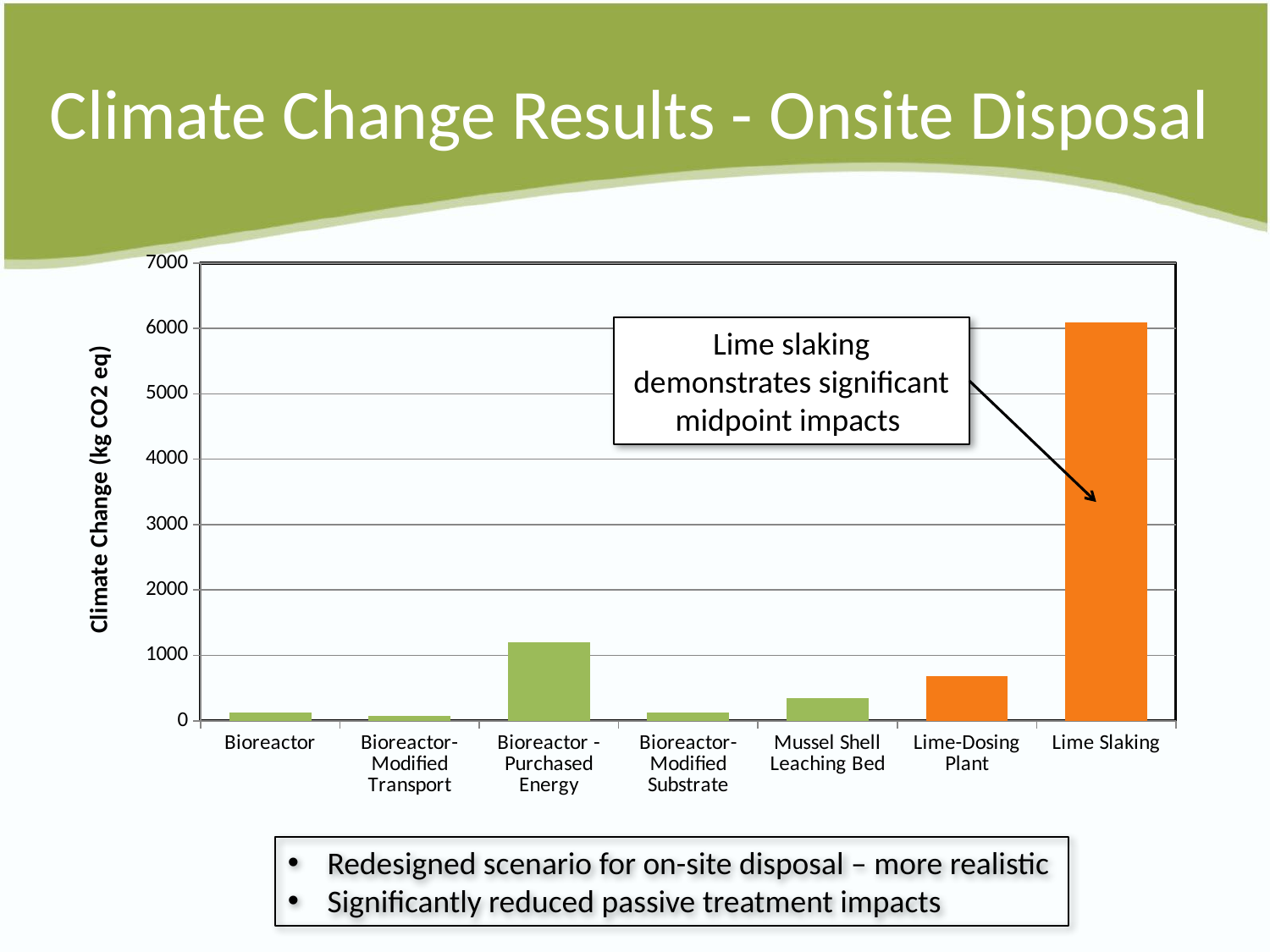
Which is larger, the value for Bioreactor - Purchased Energy or the value for Lime-Dosing Plant? Bioreactor - Purchased Energy What kind of chart is shown on the slide? bar chart Which category has the lowest climate change value? Bioreactor-Modified Transport Is the value for Mussel Shell Leaching Bed greater or less than 1000? less Is the value for Bioreactor - Purchased Energy greater or less than 1000? greater Is the value for Lime-Dosing Plant greater or less than 1000? less Which is larger, the value for Lime-Dosing Plant or the value for Mussel Shell Leaching Bed? Lime-Dosing Plant What is the label of the y axis? Climate Change (kg CO2 eq) How many categories are plotted on the x axis? 7 What colour are the bars for Lime-Dosing Plant and Lime Slaking? orange Which category has the highest climate change value? Lime Slaking